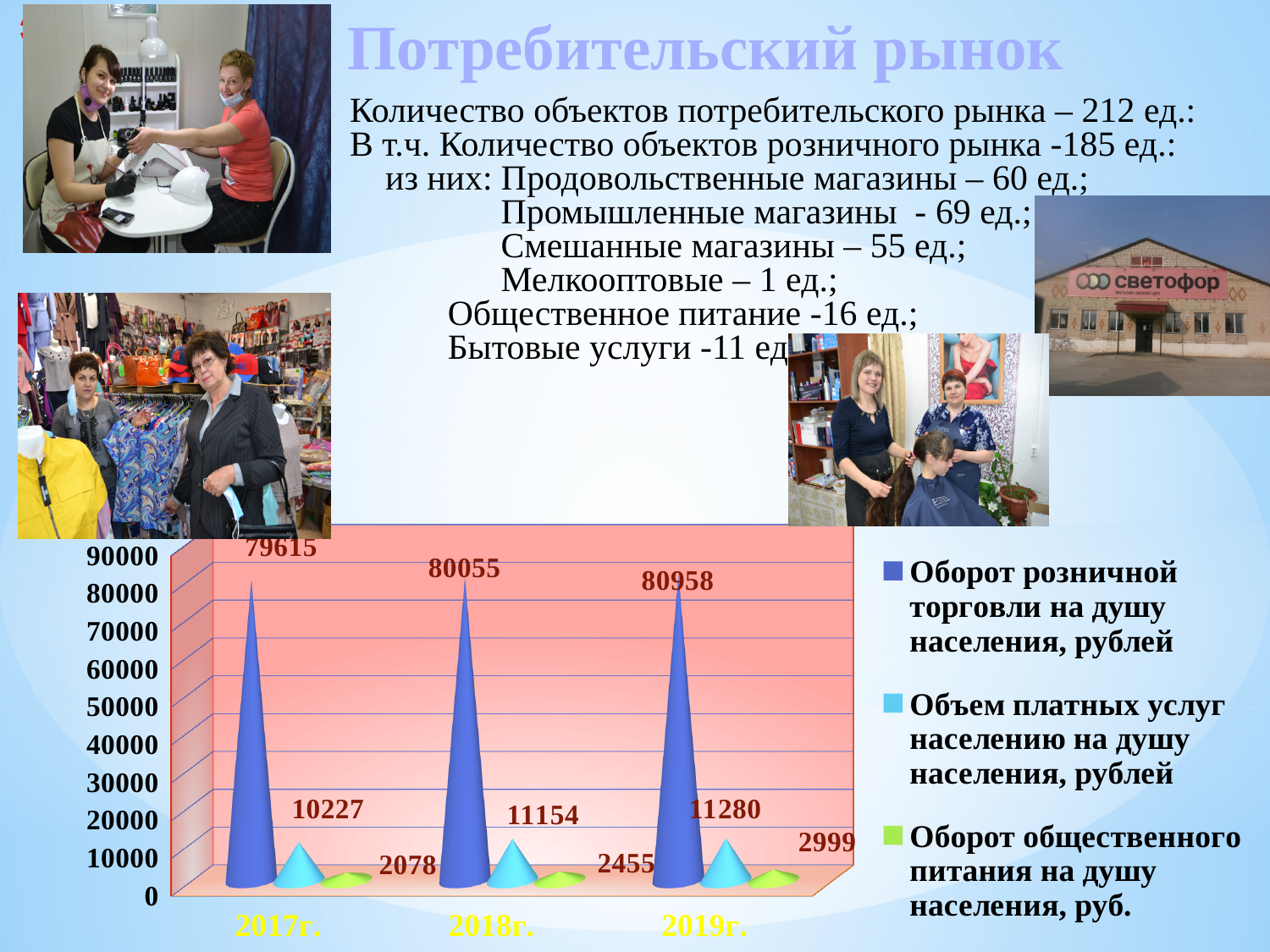
What kind of chart is shown on the slide? bar chart In which year is 'Оборот розничной торговли на душу населения, рублей' highest? 2019г. How many years are shown on the x axis of the chart? 3 What is the value of 'Объем платных услуг населению на душу населения, рублей' for 2018г.? 11154 Which is larger: 'Объем платных услуг населению на душу населения, рублей' in 2017г. or in 2019г.? 2019г. How many series does the chart legend list? 3 What is the value of 'Оборот общественного питания на душу населения, руб.' for 2019г.? 2999 Is the value of 'Оборот розничной торговли на душу населения, рублей' for 2018г. greater or less than 70000? greater What is the value of 'Оборот розничной торговли на душу населения, рублей' for 2017г.? 79615 Does 'Оборот общественного питания на душу населения, руб.' rise or fall from 2017г. to 2019г.? rise In which year is 'Оборот общественного питания на душу населения, руб.' lowest? 2017г. What is the difference between 'Оборот розничной торговли на душу населения, рублей' in 2019г. and 2017г.? 1343